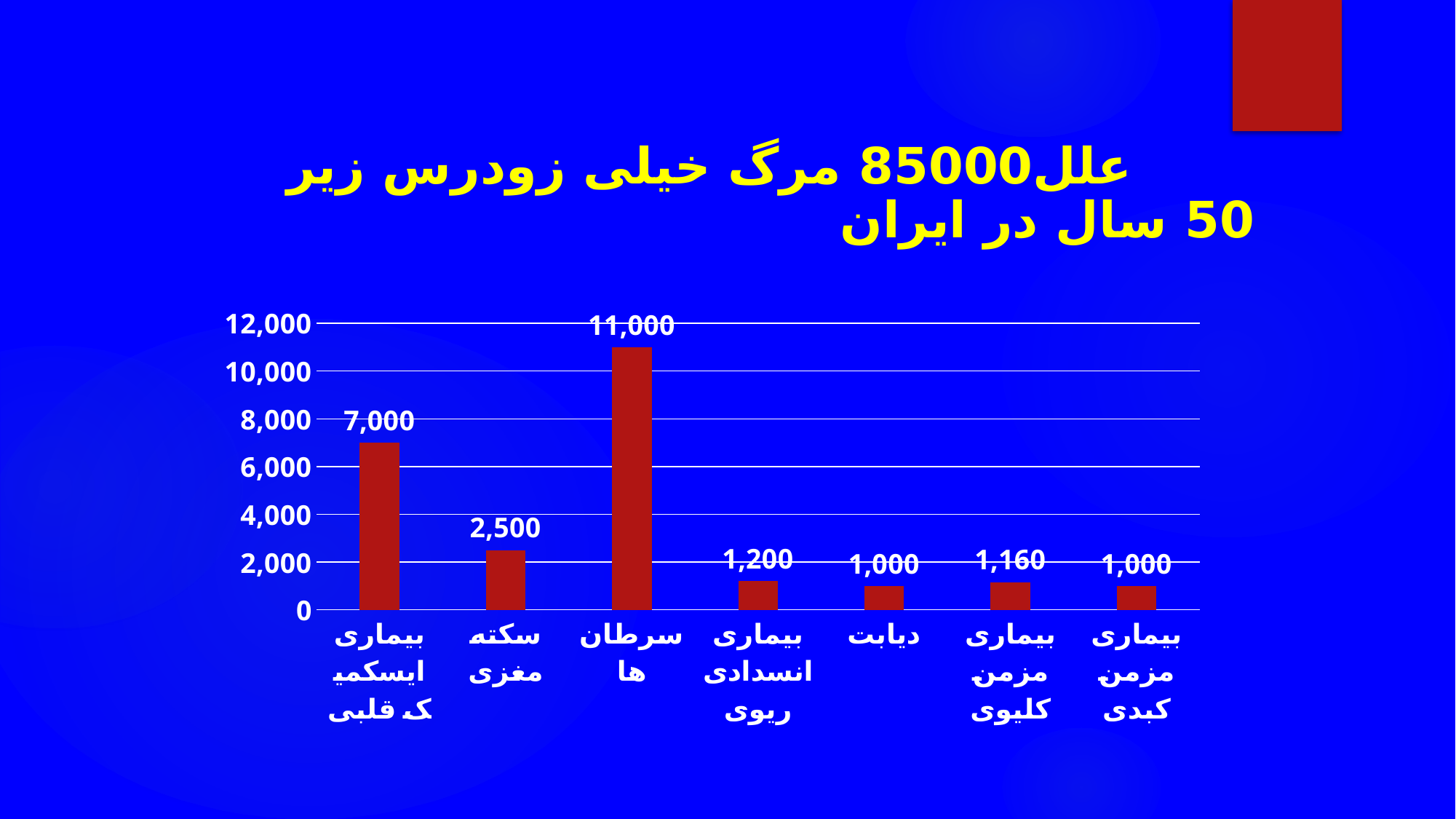
What is the value for سرطان ها? 11,000 What is the value for بیماری مزمن کلیوی? 1,160 Which category has the highest value? سرطان ها Is the value for بیماری ایسکمیک قلبی greater or less than 6,000? greater Which is larger, the value for سکته مغزی or the value for بیماری انسدادی ریوی? سکته مغزی How many categories are shown on the x axis? 7 What is the difference between the values for سرطان ها and بیماری ایسکمیک قلبی? 4,000 What colour are the bars in the chart? red What kind of chart is shown on the slide? bar chart What is the difference between the values for بیماری انسدادی ریوی and دیابت? 200 What is the value for بیماری ایسکمیک قلبی? 7,000 What is the value for سکته مغزی? 2,500